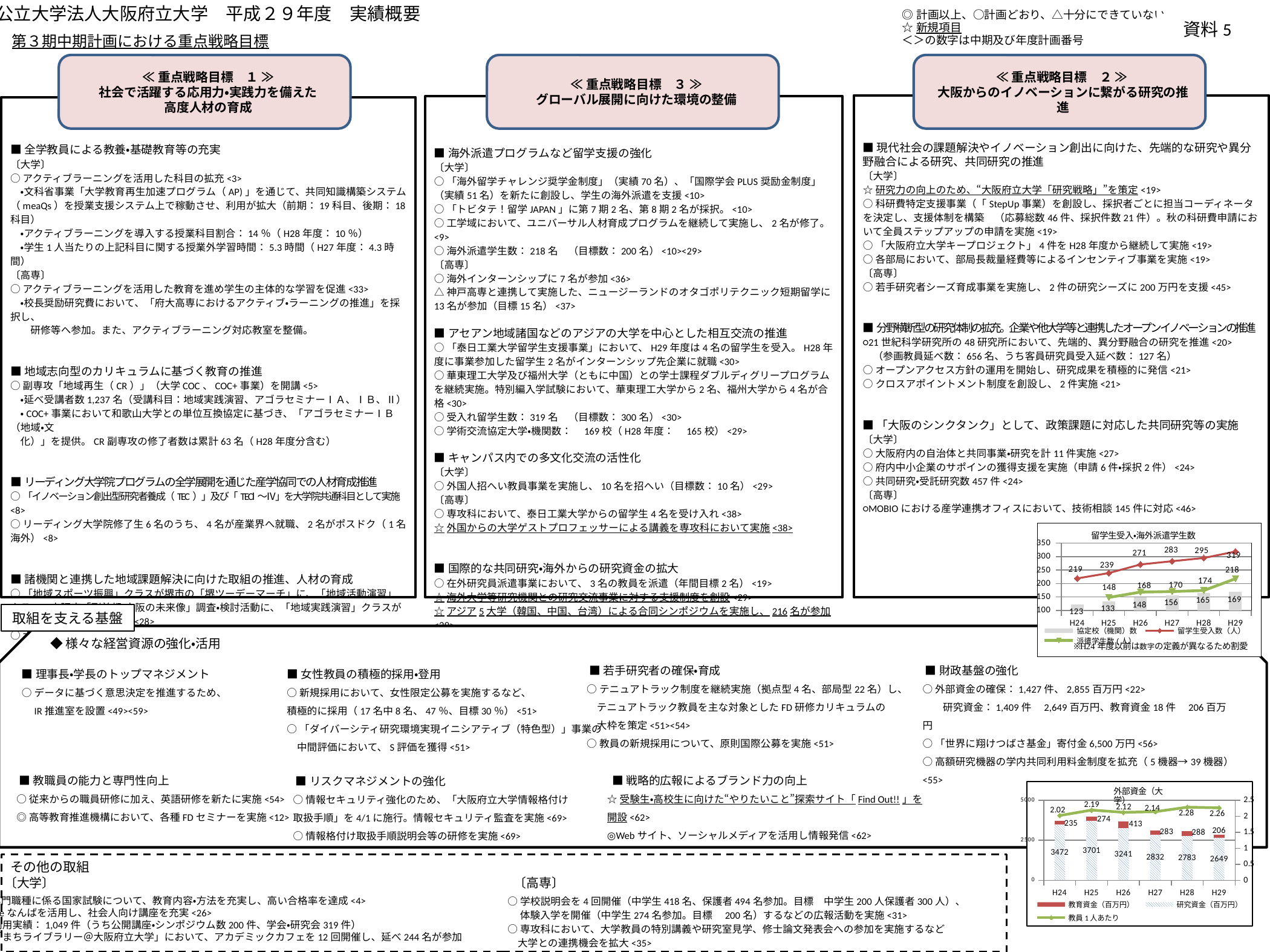
In the chart titled 留学生受入•海外派遣学生数, does 協定校（機関）数 rise or fall from H24 to H29? rise In the chart titled 外部資金（大学）, which year has the lowest 研究資金（百万円）? H29 In the chart titled 留学生受入•海外派遣学生数, which year has the highest 留学生受入数（人）? H29 In the chart titled 外部資金（大学）, what is the value of 研究資金（百万円） for H25? 3701 In the chart titled 留学生受入•海外派遣学生数, what is the value of 留学生受入数（人） for H29? 319 In the chart titled 外部資金（大学）, what is the value of 教員1人あたり for H28? 2.28 In the chart titled 外部資金（大学）, how many years are shown on the x axis? 6 In the chart titled 留学生受入•海外派遣学生数, what is the value of 派遣学生数（人） for H28? 174 In the chart titled 外部資金（大学）, what is the value of 教育資金（百万円） for H26? 413 In the chart titled 留学生受入•海外派遣学生数, what is the difference between 留学生受入数（人） in H29 and H24? 100 In the chart titled 留学生受入•海外派遣学生数, what is the value of 協定校（機関）数 for H24? 123 In the chart titled 留学生受入•海外派遣学生数, how many series does the legend list? 3